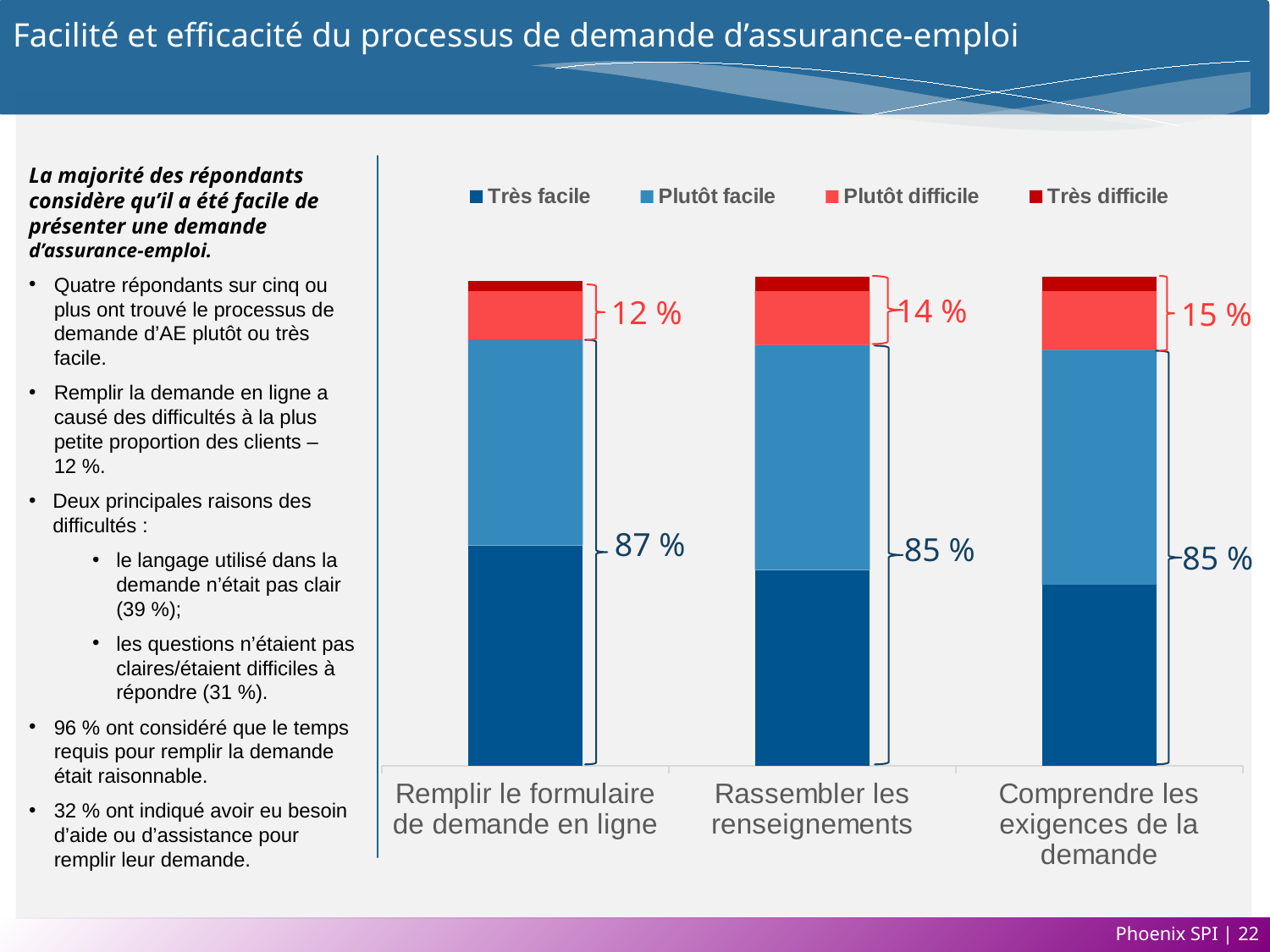
How many series does the chart legend list? 4 What combined percentage is labelled for the easy (blue) portion of the "Rassembler les renseignements" bar? 85 % Which category has the highest labelled percentage of respondents finding it plutôt or très facile? Remplir le formulaire de demande en ligne What combined percentage of respondents found "Remplir le formulaire de demande en ligne" plutôt or très facile, as labelled on the chart? 87 % How many categories are shown on the x axis of the chart? 3 Which category has the lowest labelled percentage of respondents finding it plutôt or très difficile? Remplir le formulaire de demande en ligne What is the difference in percentage points between the difficult share for "Comprendre les exigences de la demande" (15 %) and for "Remplir le formulaire de demande en ligne" (12 %)? 3 What combined percentage of respondents found "Comprendre les exigences de la demande" plutôt or très difficile, as labelled on the chart? 15 % Which category has the highest labelled percentage of respondents finding it plutôt or très difficile? Comprendre les exigences de la demande What combined percentage is labelled for the difficult (red) portion of the "Rassembler les renseignements" bar? 14 % What kind of chart is shown on the slide? Stacked bar chart Which is larger: the difficult share for "Rassembler les renseignements" or for "Remplir le formulaire de demande en ligne"? Rassembler les renseignements